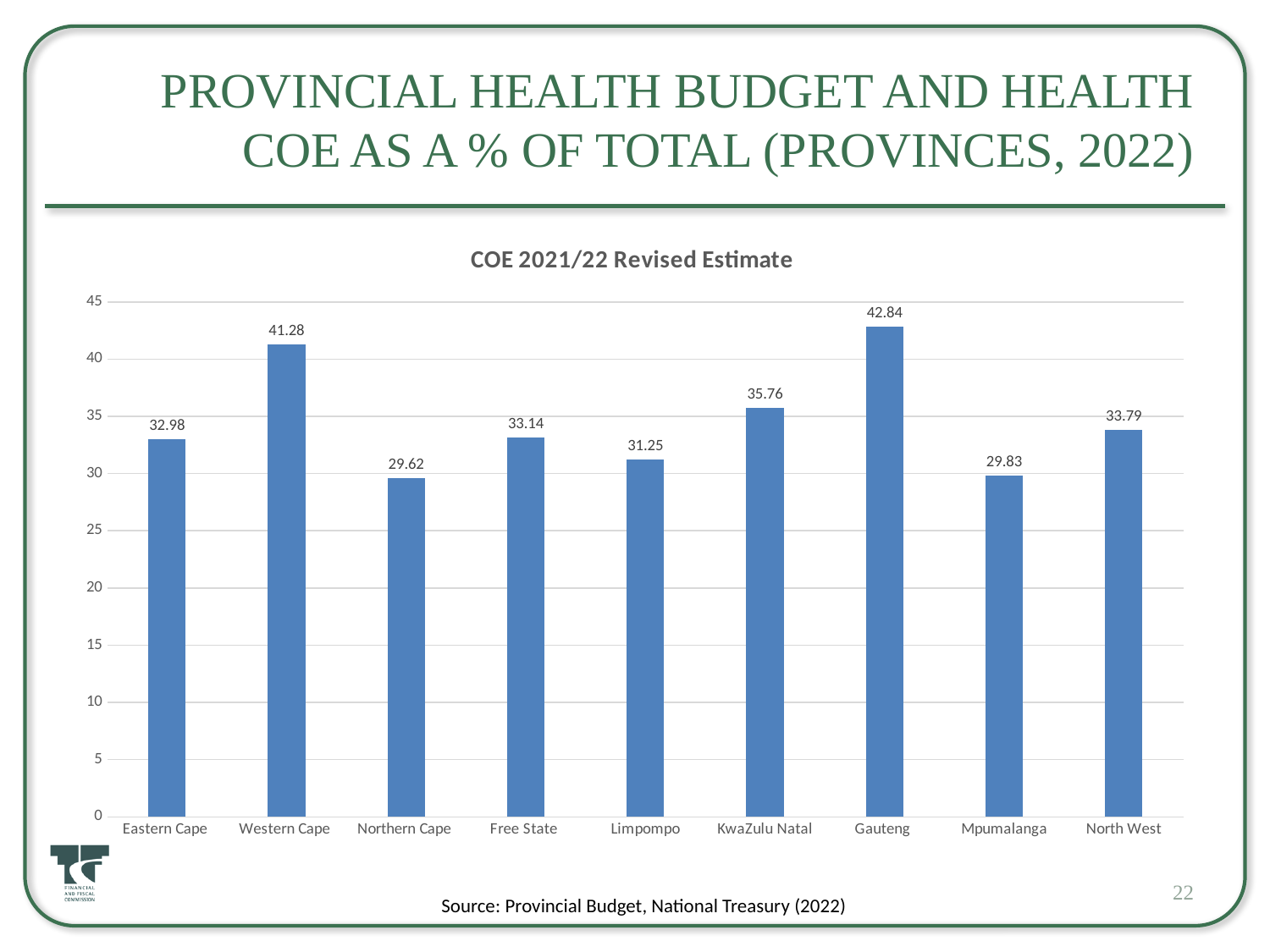
What kind of chart is shown on the slide? Bar chart What is the difference between the values for Gauteng and Western Cape? 1.56 Which has a larger value, Free State or North West? North West What is the COE 2021/22 Revised Estimate value for Northern Cape? 29.62 What is the COE 2021/22 Revised Estimate value for Gauteng? 42.84 Which province has the lowest COE 2021/22 Revised Estimate? Northern Cape What is the COE 2021/22 Revised Estimate value for KwaZulu Natal? 35.76 Which province has the highest COE 2021/22 Revised Estimate? Gauteng What is the difference between the values for Eastern Cape and Limpompo? 1.73 What is the title of the chart? COE 2021/22 Revised Estimate How many provinces are shown on the chart? 9 Is the value for Mpumalanga greater or less than 30? less